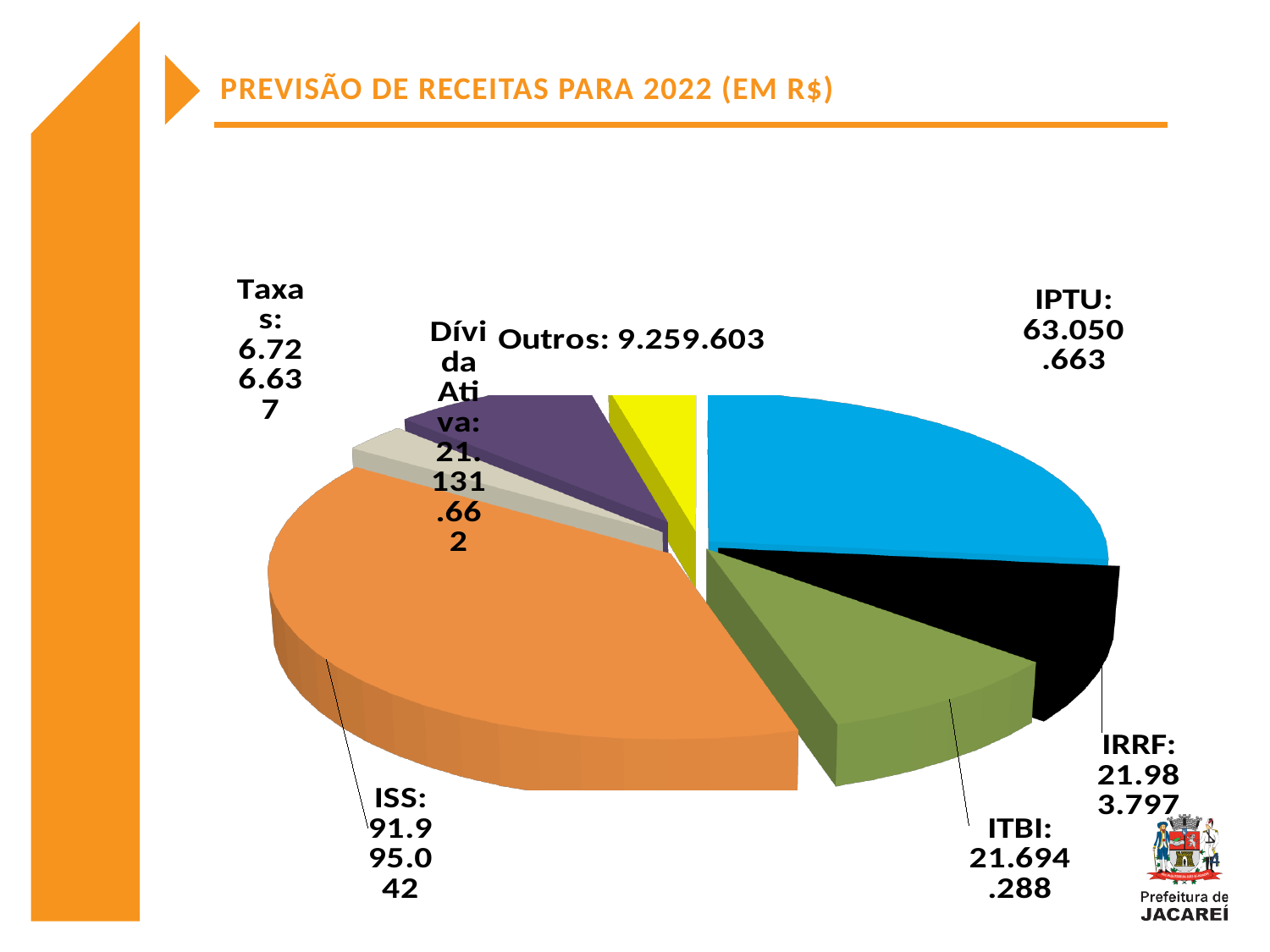
What is the value shown for Dívida Ativa? 21.131.662 What is the difference between the value for ISS and the value for IPTU? 28.944.379 Which category has the smallest slice of the pie? Taxas Which category has the largest slice of the pie? ISS What is the value shown for IPTU? 63.050.663 What is the value shown for ISS? 91.995.042 What is the value shown for Outros? 9.259.603 What colour is the ISS slice of the pie? Orange What is the title of the chart on the slide? PREVISÃO DE RECEITAS PARA 2022 (EM R$) How many slices does the pie chart have? 7 What type of chart is shown on the slide? Pie chart Which is larger, the value for IRRF or the value for ITBI? IRRF